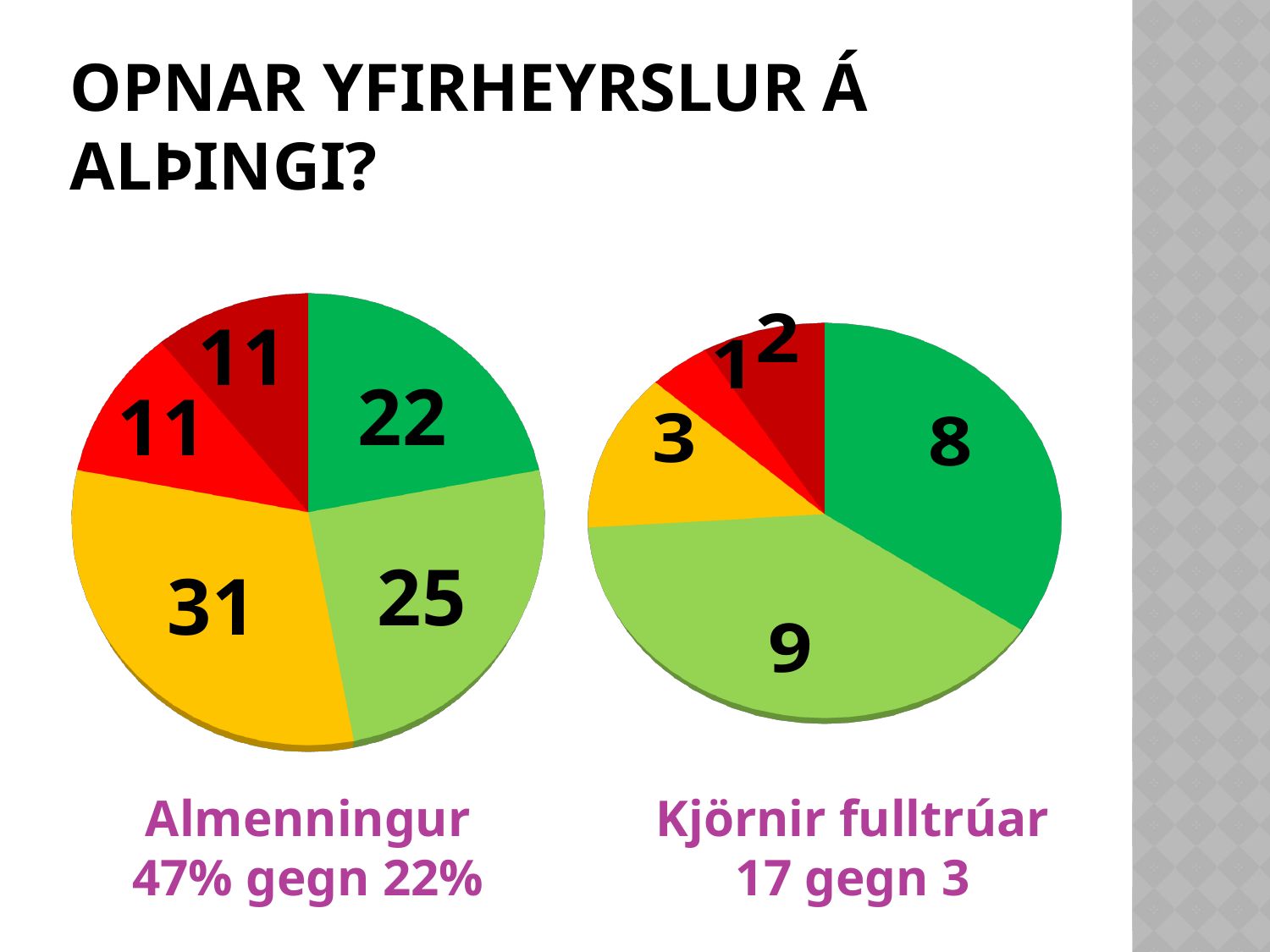
In the Kjörnir fulltrúar pie chart, which slice is the smallest? the red slice (1) In the Almenningur pie chart, which slice is the largest? the yellow slice (31) What is the total of all slices in the Almenningur pie chart? 100 In the Kjörnir fulltrúar pie chart, what is the value of the light green slice? 9 In the Kjörnir fulltrúar pie chart, what is the difference between the dark green slice and the yellow slice? 5 How many slices does the Almenningur pie chart have? 5 In the Almenningur pie chart, what is the difference between the light green slice and the dark green slice? 3 What kind of chart is the left chart labelled Almenningur? pie chart How many slices does the Kjörnir fulltrúar pie chart have? 5 In the Almenningur pie chart, what is the value of the yellow slice? 31 What is the label under the right pie chart? Kjörnir fulltrúar In the Kjörnir fulltrúar pie chart, which is larger, the light green slice or the dark green slice? the light green slice